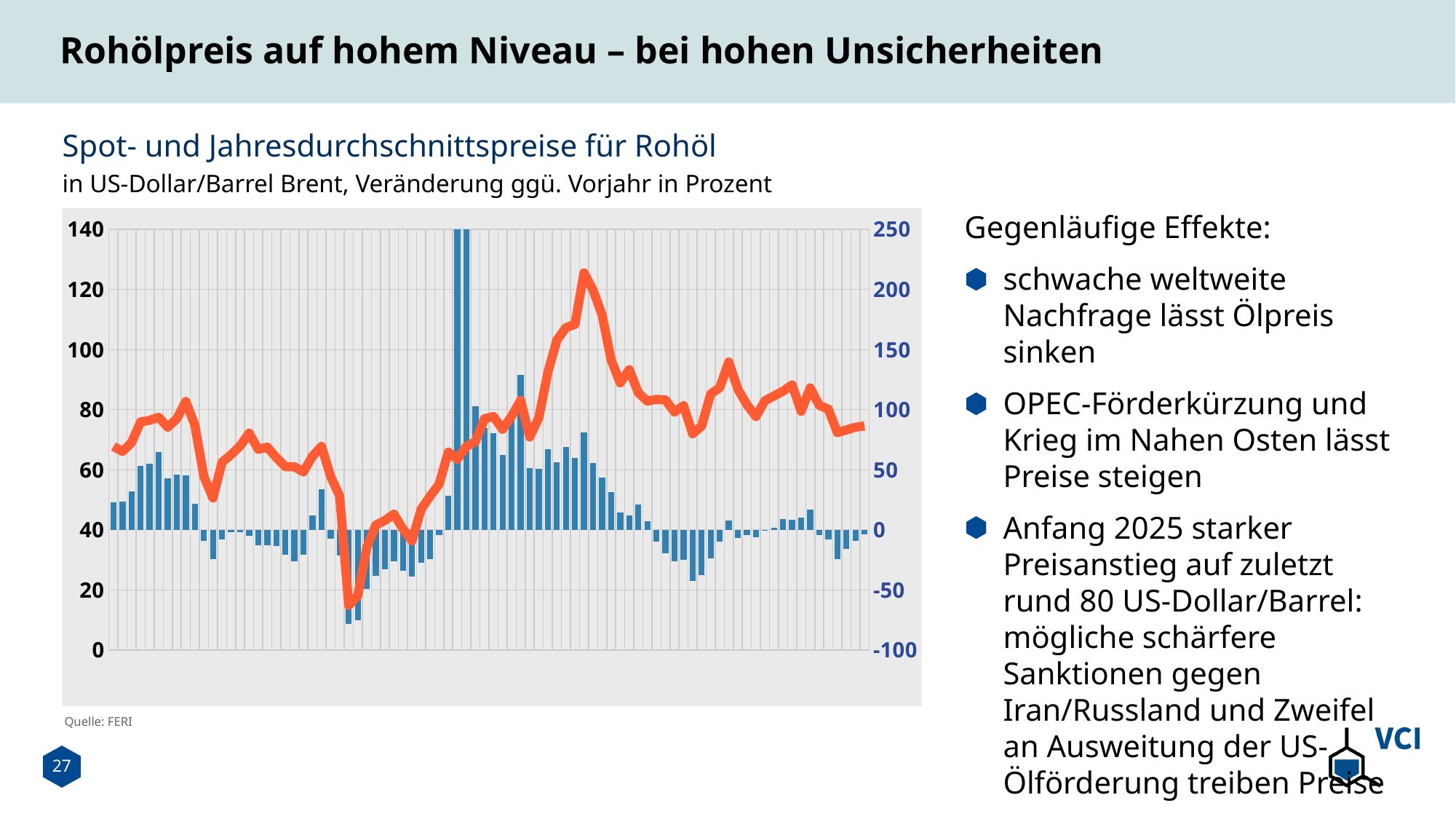
What is the title of the chart? Spot- und Jahresdurchschnittspreise für Rohöl Is the lowest point of the orange line greater or less than 20 on the left axis? less What kind of chart is shown on the slide? A combined bar and line chart Do the two tallest blue bars reach above 250 on the right axis? Yes Is the lowest blue bar greater or less than -50 on the right axis? less What is the highest value shown on the left vertical axis of the chart? 140